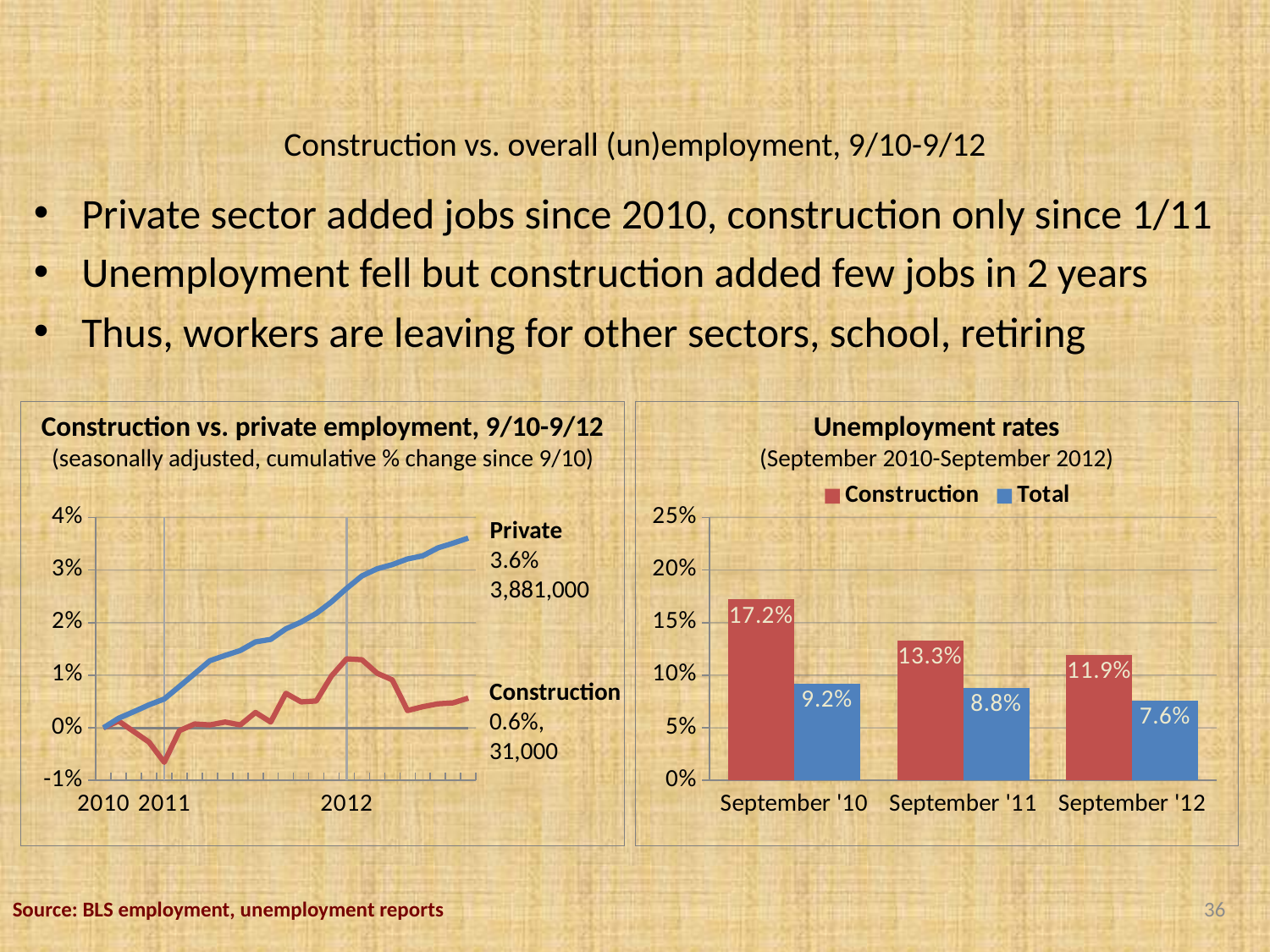
In the 'Construction vs. private employment, 9/10-9/12' chart, does the Private line rise or fall from 2010 to 2012? Rise In the 'Unemployment rates' chart, what is the difference between the Construction and Total unemployment rates in September '10? 8.0% What kind of chart is the 'Unemployment rates' chart? Bar chart In the 'Unemployment rates' chart, how many time periods are shown on the x axis? 3 In the 'Unemployment rates' chart, what is the Total unemployment rate for September '12? 7.6% In the 'Unemployment rates' chart, which period has the lowest Total unemployment rate? September '12 In the 'Construction vs. private employment, 9/10-9/12' chart, what is the cumulative % change for Private at the end of the period? 3.6% In the 'Unemployment rates' chart, what is the Construction unemployment rate for September '10? 17.2% In the 'Unemployment rates' chart, which is larger: the Construction rate in September '12 or the Total rate in September '10? Construction rate in September '12 In the 'Unemployment rates' chart, which period has the highest Construction unemployment rate? September '10 In the 'Unemployment rates' chart, how many series does the legend list? 2 In the 'Unemployment rates' chart, what is the Total unemployment rate for September '11? 8.8%